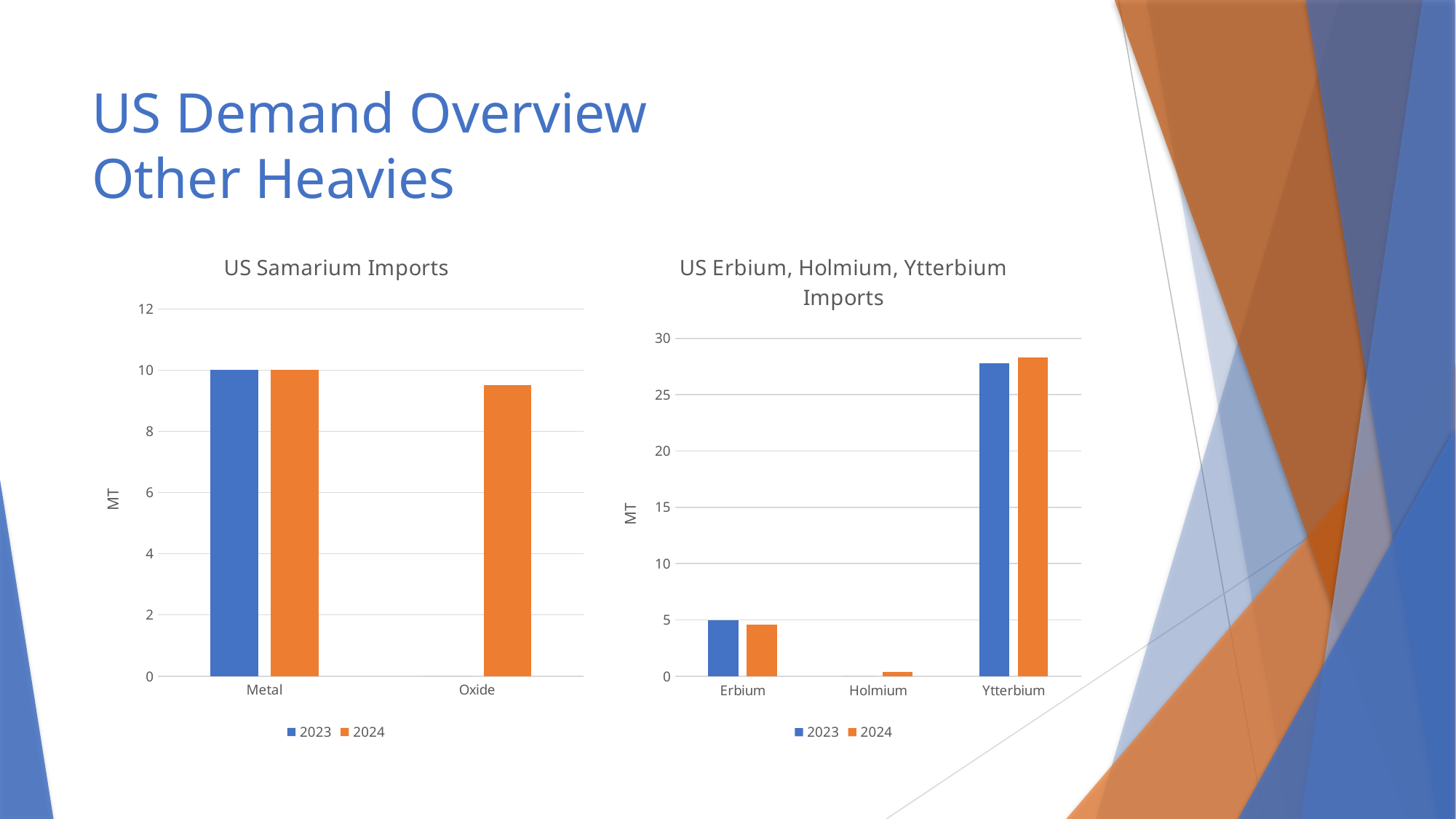
On the US Samarium Imports chart, what is the value for Metal in 2023? 10 On the US Erbium, Holmium, Ytterbium Imports chart, is the 2023 value for Ytterbium greater or less than 25? greater On the US Erbium, Holmium, Ytterbium Imports chart, is the 2024 value for Holmium greater or less than 5? less How many categories are shown on the US Erbium, Holmium, Ytterbium Imports chart? 3 On the US Erbium, Holmium, Ytterbium Imports chart, which category has the highest imports? Ytterbium How many series does the legend of the US Samarium Imports chart list? 2 On the US Samarium Imports chart, which is larger for Oxide: the 2023 value or the 2024 value? 2024 On the US Erbium, Holmium, Ytterbium Imports chart, what is the value for Erbium in 2023? 5 What kind of chart is the US Samarium Imports chart? bar chart On the US Erbium, Holmium, Ytterbium Imports chart, which category has the lowest imports? Holmium What is the y-axis label on the US Erbium, Holmium, Ytterbium Imports chart? MT On the US Samarium Imports chart, is the 2024 value for Oxide greater or less than 8? greater